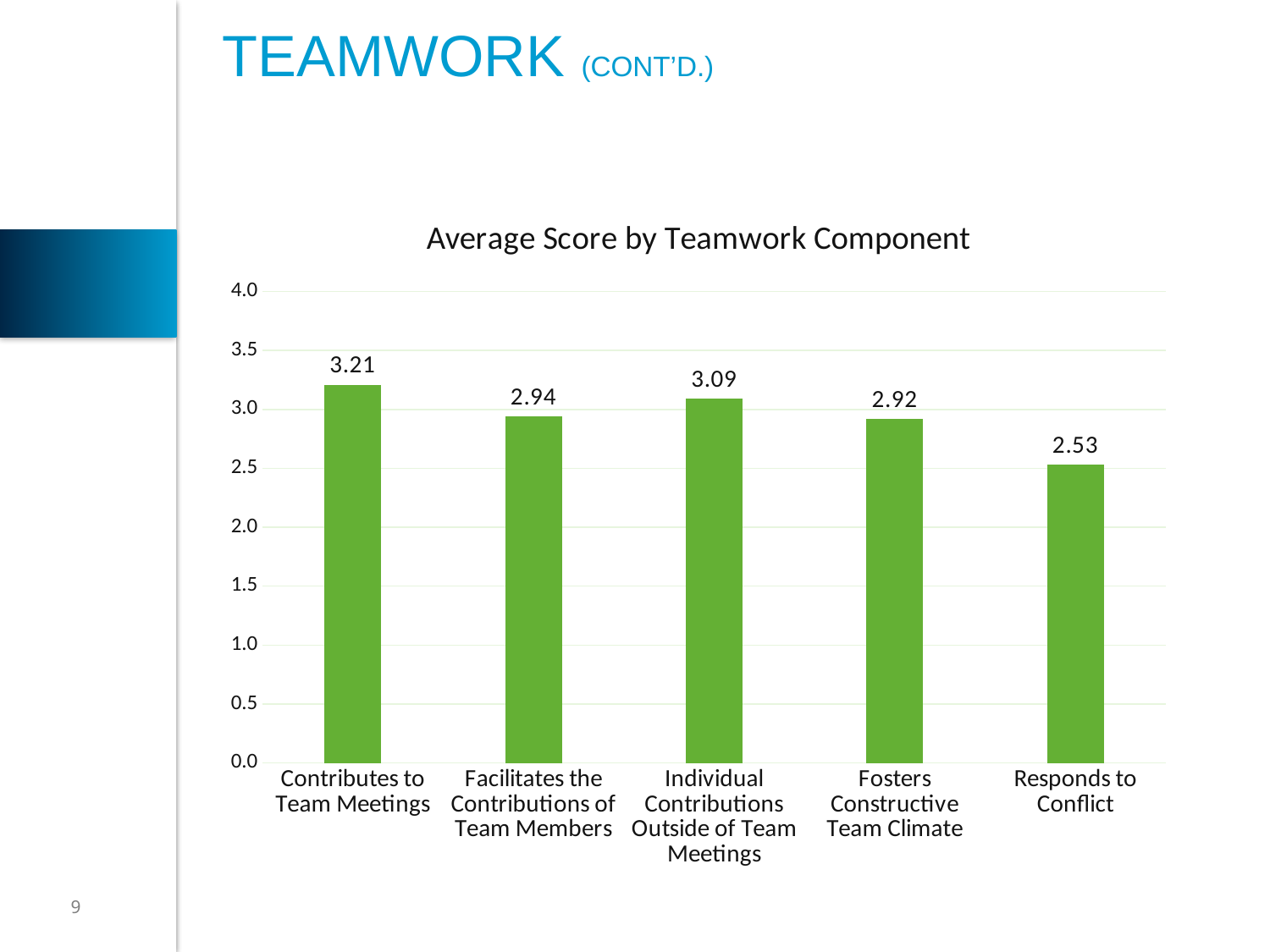
What is the title of the chart? Average Score by Teamwork Component Which has a higher average score, Facilitates the Contributions of Team Members or Individual Contributions Outside of Team Meetings? Individual Contributions Outside of Team Meetings What is the average score for Individual Contributions Outside of Team Meetings? 3.09 Which teamwork component has the lowest average score? Responds to Conflict What is the maximum value shown on the vertical axis? 4.0 What is the average score for Responds to Conflict? 2.53 Which teamwork component has the highest average score? Contributes to Team Meetings How many teamwork components are shown in the chart? 5 What is the average score for Contributes to Team Meetings? 3.21 What kind of chart is shown on the slide? bar chart Is the average score for Fosters Constructive Team Climate greater or less than 3.0? less What is the difference between the average scores for Contributes to Team Meetings and Responds to Conflict? 0.68